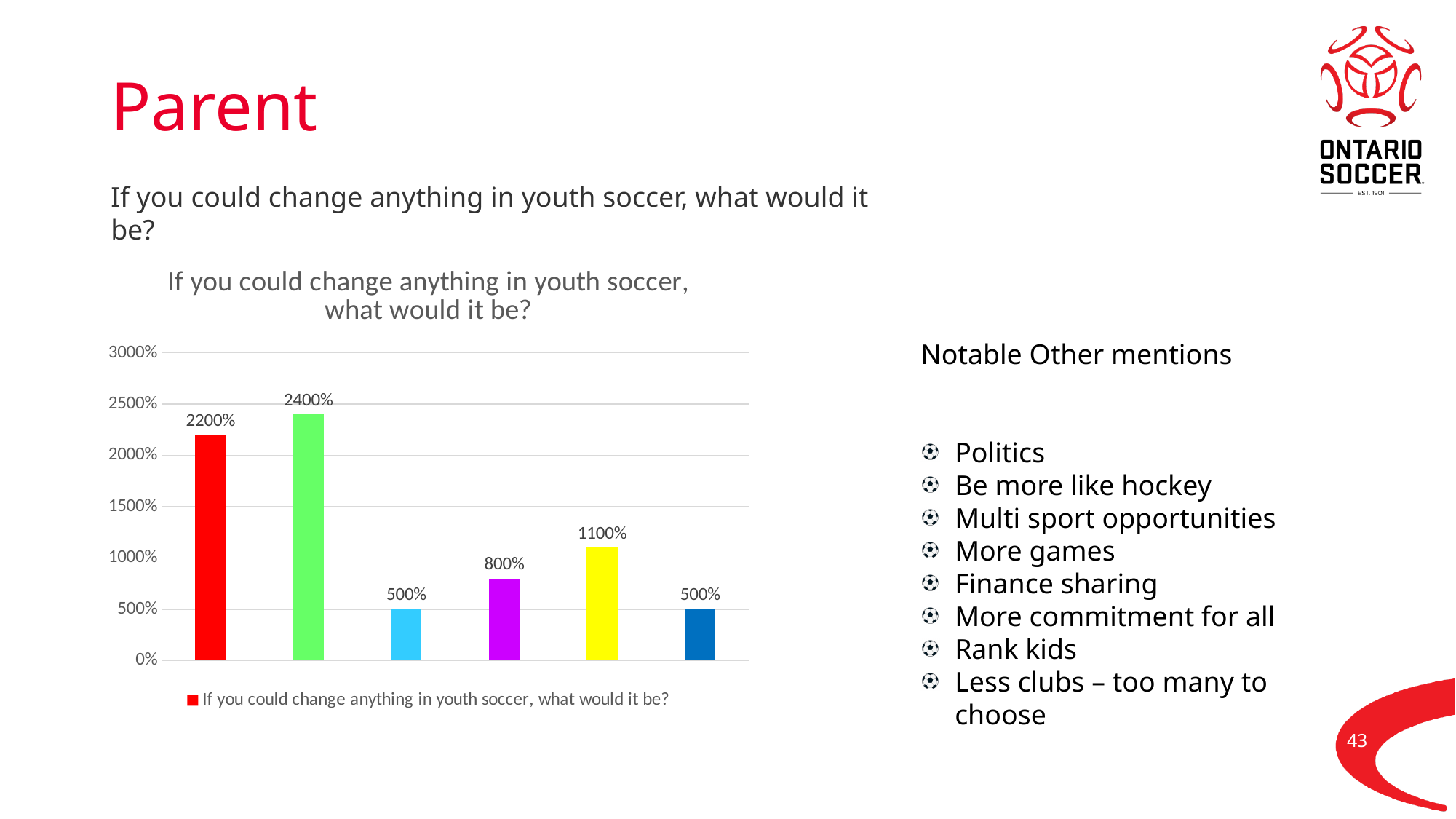
Which is larger, the yellow bar or the purple bar? the yellow bar What is the difference between the green bar (2400%) and the red bar (2200%)? 200% How many series does the chart legend list? 1 What is the value of the red bar (first from the left)? 2200% What is the title of the chart? If you could change anything in youth soccer, what would it be? Is the value of the yellow bar greater or less than 1000%? greater What is the value of the yellow bar (fifth from the left)? 1100% How many bars are plotted in the chart? 6 Which bar has the highest value? the green bar (second from the left), 2400% What type of chart is shown on the slide? bar chart What is the value of the purple bar (fourth from the left)? 800% What is the value of the green bar (second from the left)? 2400%